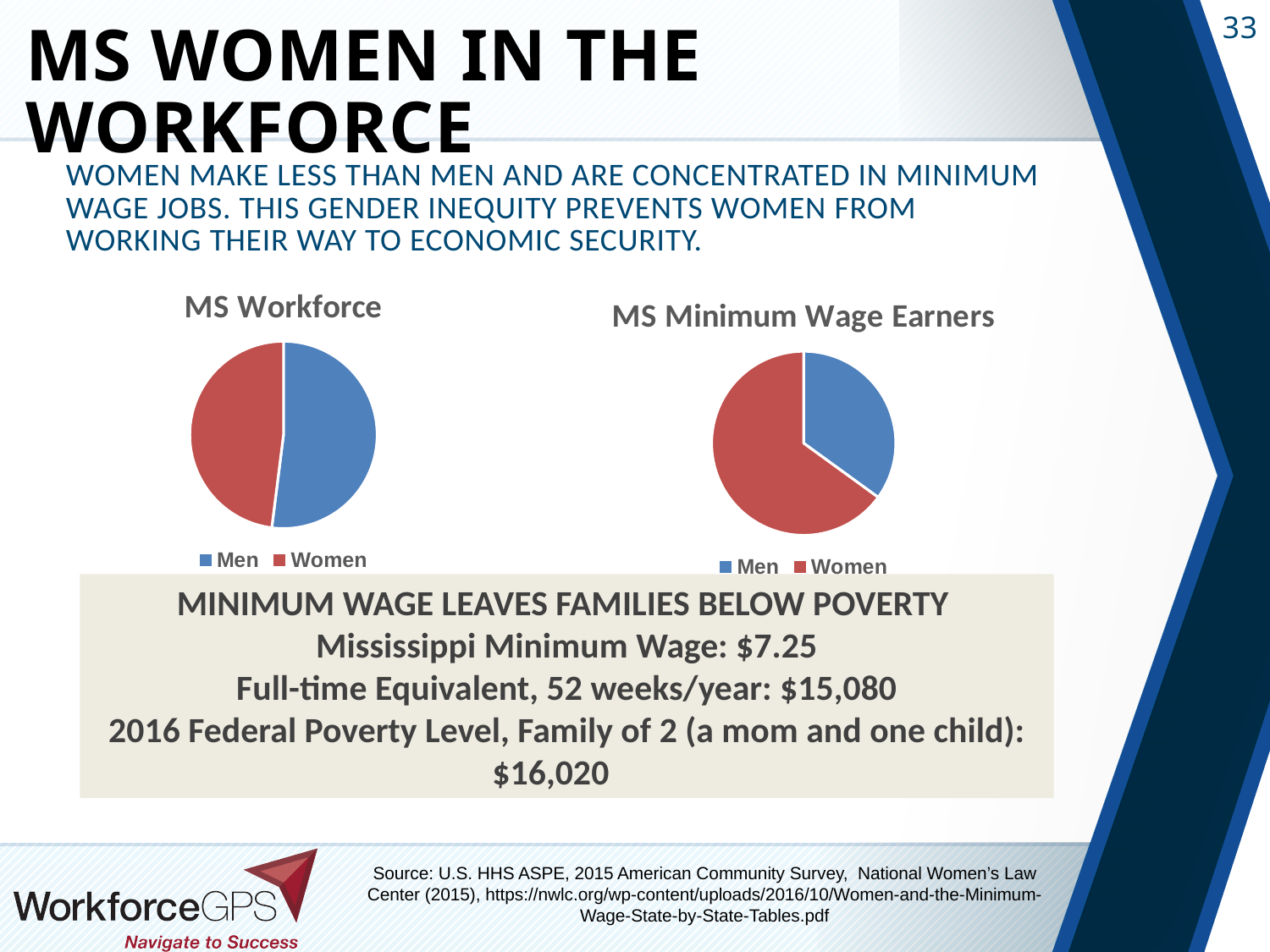
In the "MS Minimum Wage Earners" chart, is the slice for Men or Women larger? Women In the "MS Workforce" chart, what colour represents Women? Red What are the two categories shown in the legend of the "MS Minimum Wage Earners" chart? Men and Women In the "MS Minimum Wage Earners" chart, which category has the largest slice? Women What kind of chart is the "MS Minimum Wage Earners" chart? Pie chart In the "MS Minimum Wage Earners" chart, which category has the smallest slice? Men How many slices does the "MS Minimum Wage Earners" pie chart have? 2 What kind of chart is the "MS Workforce" chart? Pie chart How many entries does the legend of the "MS Workforce" chart list? 2